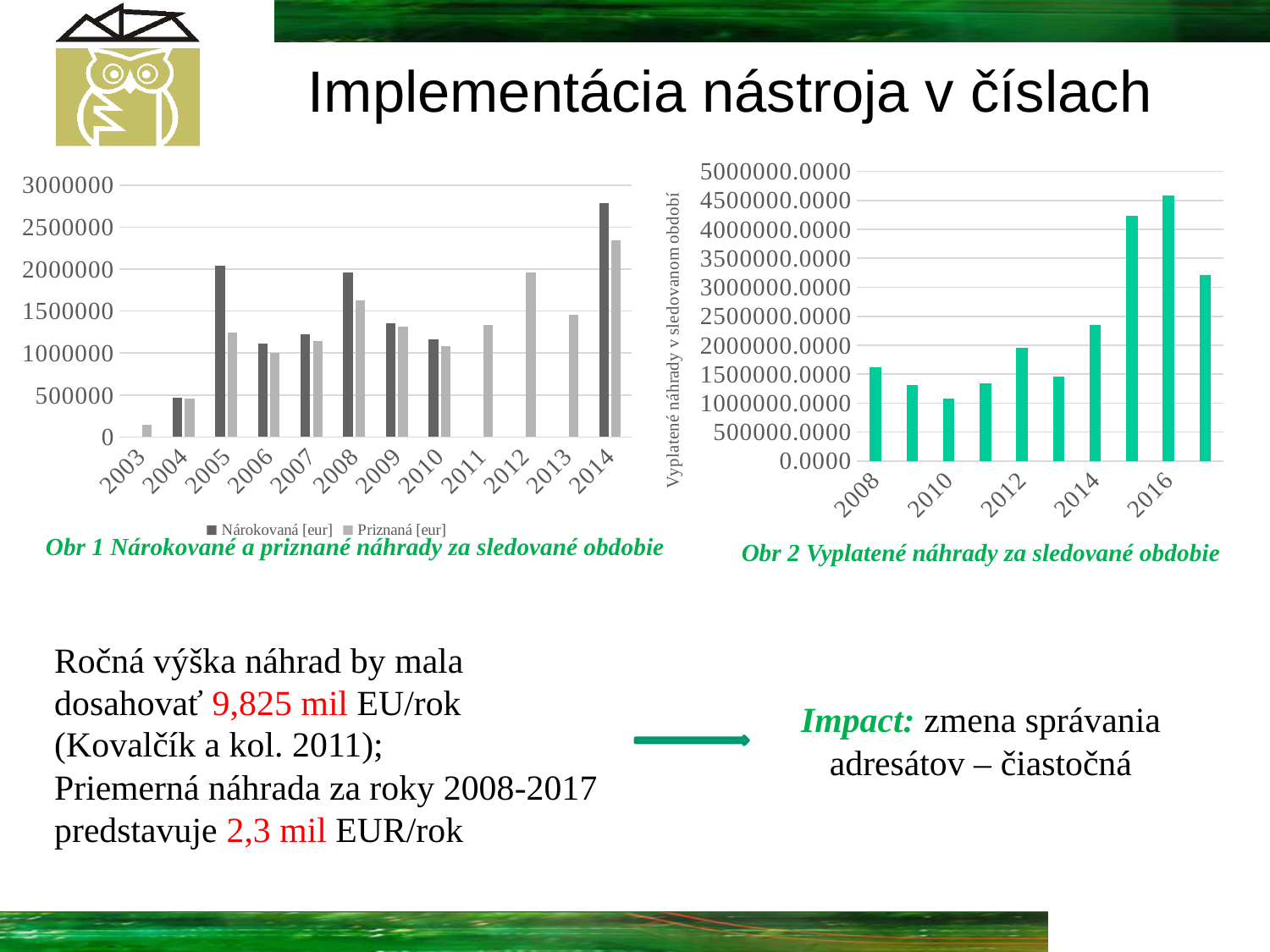
What kind of chart is Obr 1 (the left chart)? bar chart In Obr 2 (the right chart), which year has the highest value? 2016 In Obr 1 (the left chart), which year has the lowest Priznaná [eur] value? 2003 What kind of chart is Obr 2 (the right chart)? bar chart In Obr 2 (the right chart), which is larger, the value for 2012 or the value for 2010? 2012 How many series does the legend of Obr 1 (the left chart) list? 2 In Obr 1 (the left chart), which year has the highest Nárokovaná [eur] value? 2014 In Obr 2 (the right chart), is the value for 2015 greater or less than 4000000.0000? greater In Obr 1 (the left chart), is the Nárokovaná [eur] value for 2014 greater or less than 2500000? greater In Obr 1 (the left chart), is the Priznaná [eur] value for 2004 greater or less than 500000? less How many bars are plotted in Obr 2 (the right chart)? 10 How many years are shown on the x axis of Obr 1 (the left chart)? 12